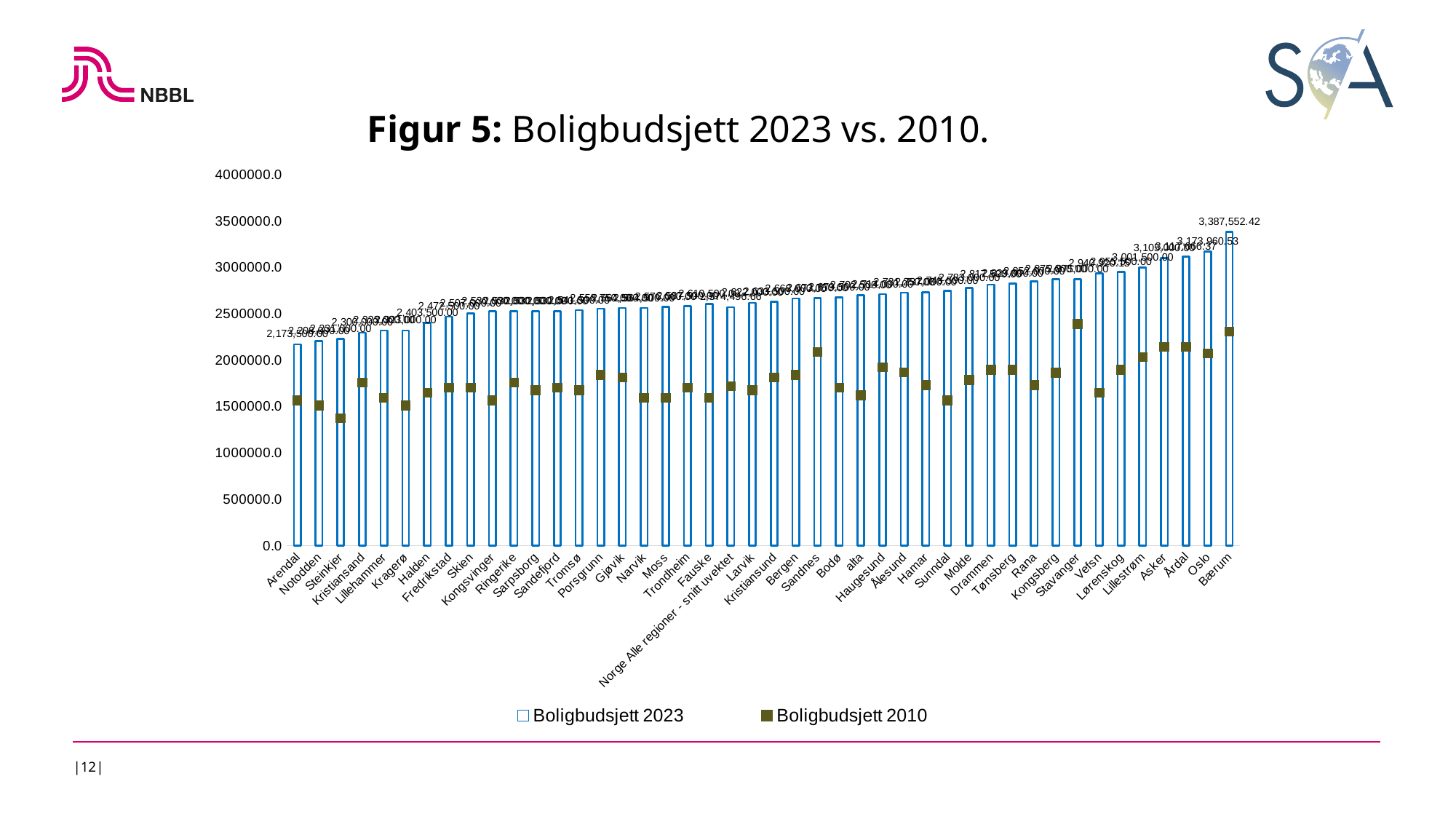
What is the title of the chart? Figur 5: Boligbudsjett 2023 vs. 2010. How many series does the legend list? 2 Which category has the lowest Boligbudsjett 2010 value? Steinkjer Is the Boligbudsjett 2010 value for Stavanger greater or less than 2000000.0? greater Do the Boligbudsjett 2023 values rise or fall from left to right along the x axis? rise What is the Boligbudsjett 2023 value for Bærum? 3,387,552.42 Which is larger, the Boligbudsjett 2010 value for Stavanger or for Steinkjer? Stavanger What kind of chart is shown on the slide? bar chart Which category has the lowest Boligbudsjett 2023 value? Arendal Is the Boligbudsjett 2023 value for Arendal greater or less than 2500000.0? less Which category has the highest Boligbudsjett 2023 value? Bærum Is the Boligbudsjett 2010 value for Steinkjer greater or less than 1500000.0? less